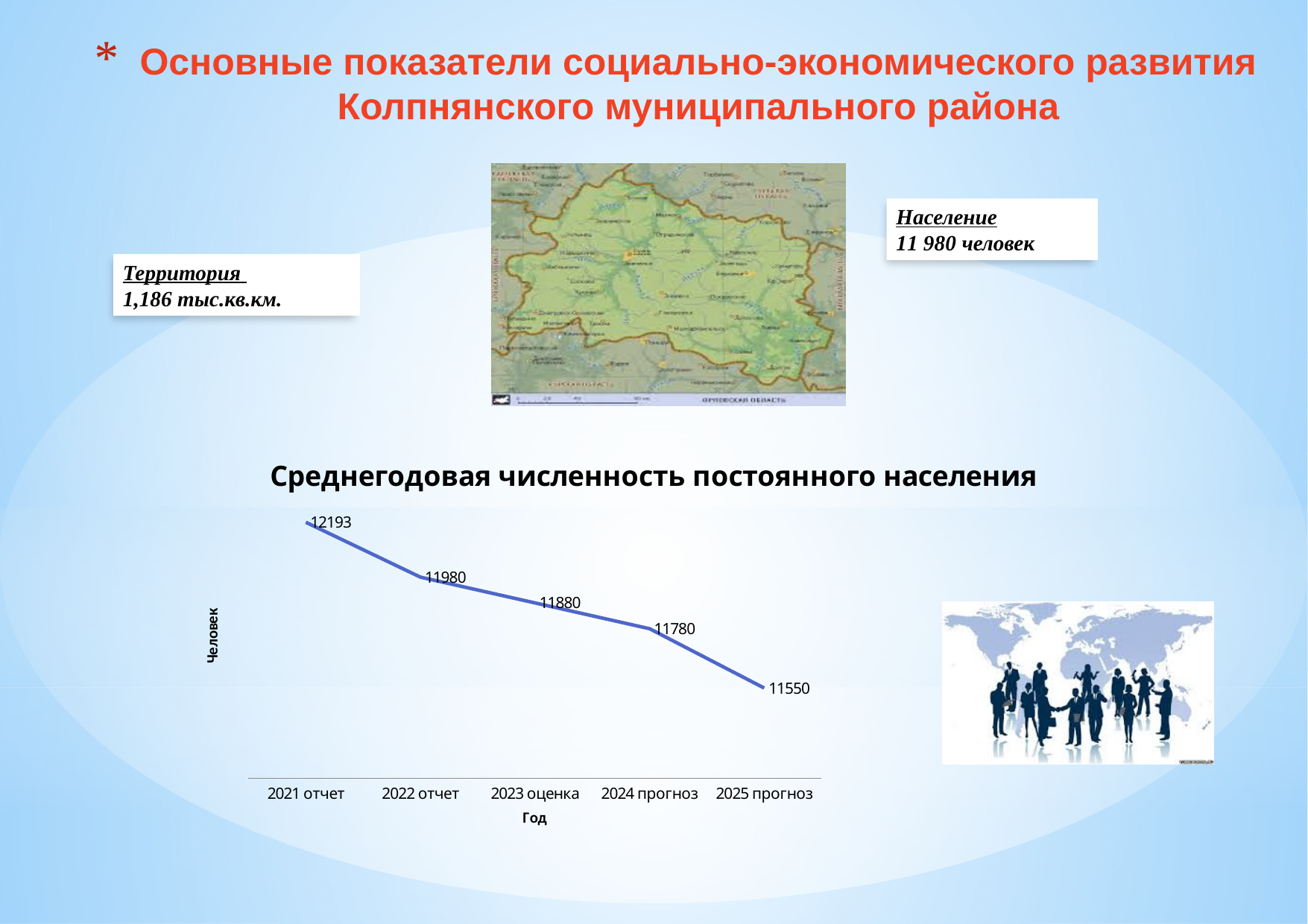
Do the values rise or fall from 2021 to 2025? fall What is the value for 2025 прогноз? 11550 What is the difference between the values for 2024 прогноз and 2025 прогноз? 230 Which year has the lowest value? 2025 прогноз What is the value for 2021 отчет? 12193 What kind of chart is shown? line chart What is the title of the chart? Среднегодовая численность постоянного населения What is the difference between the values for 2021 отчет and 2022 отчет? 213 What is the value for 2023 оценка? 11880 Which is larger, the value for 2022 отчет or the value for 2024 прогноз? 2022 отчет Which year has the highest value? 2021 отчет How many data points are plotted on the chart? 5